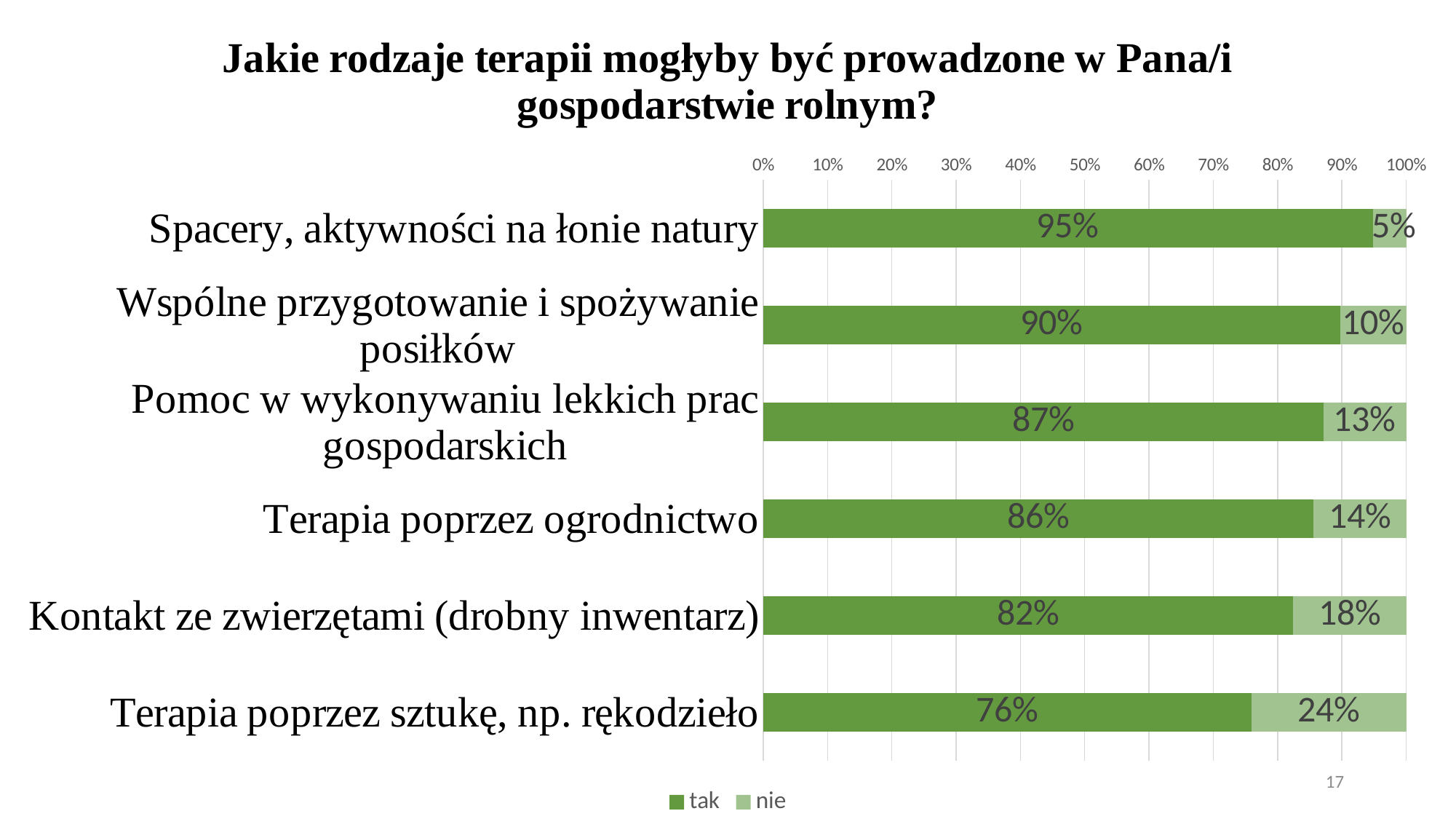
Which category has the highest "tak" value? Spacery, aktywności na łonie natury What kind of chart is shown on the slide? Stacked bar chart What is the "tak" value for "Spacery, aktywności na łonie natury"? 95% How many series does the legend list? 2 What is the difference between the "tak" values for "Wspólne przygotowanie i spożywanie posiłków" and "Terapia poprzez ogrodnictwo"? 4% Which has a larger "nie" value: "Pomoc w wykonywaniu lekkich prac gospodarskich" or "Kontakt ze zwierzętami (drobny inwentarz)"? Kontakt ze zwierzętami (drobny inwentarz) What is the "tak" value for "Kontakt ze zwierzętami (drobny inwentarz)"? 82% What is the "nie" value for "Terapia poprzez sztukę, np. rękodzieło"? 24% What is the total of the stacked bar for "Terapia poprzez ogrodnictwo"? 100% How many categories are shown in the chart? 6 Which category has the lowest "tak" value? Terapia poprzez sztukę, np. rękodzieło What are the two series named in the legend? tak, nie